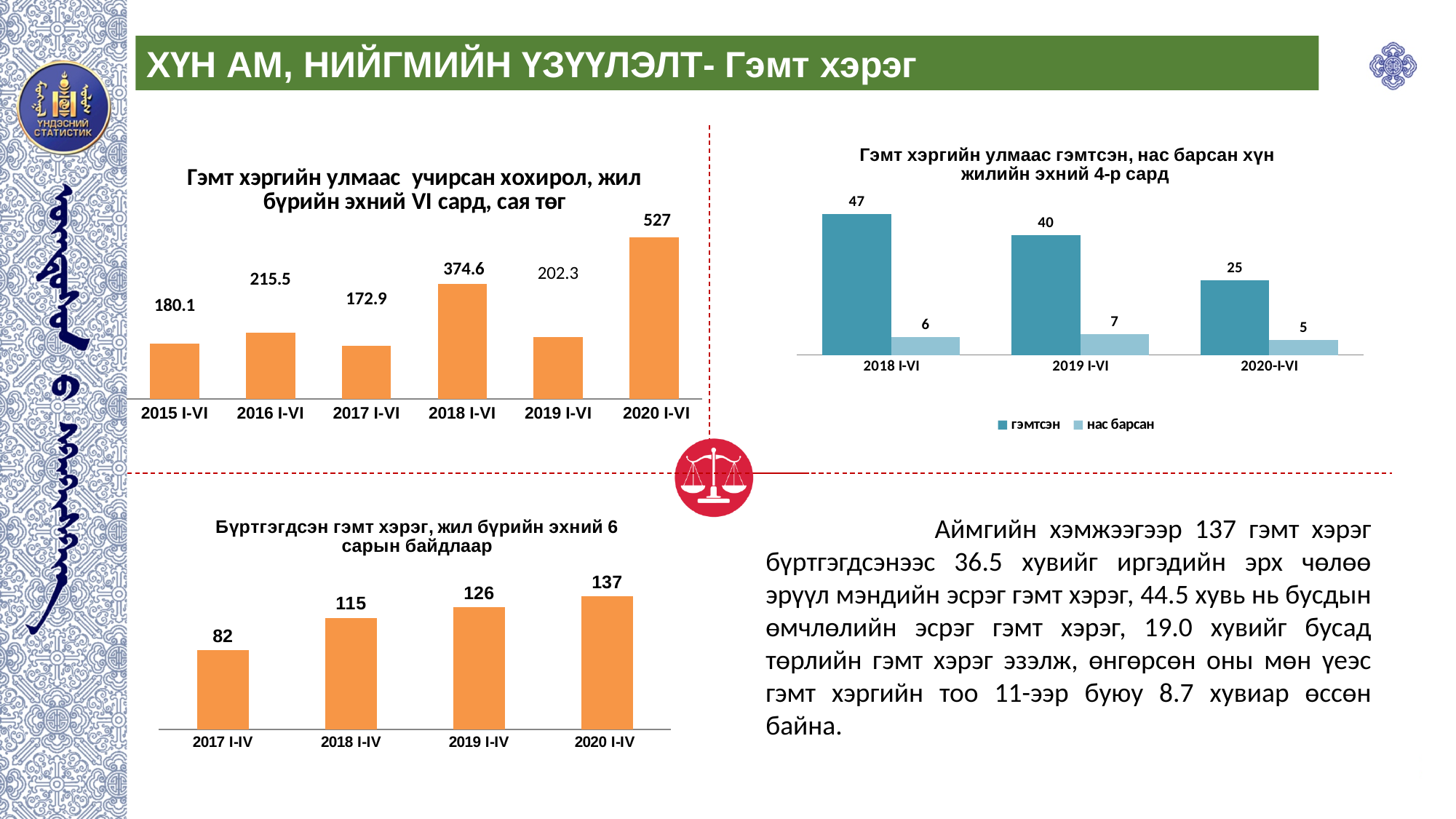
In the top-right chart (Гэмт хэргийн улмаас гэмтсэн, нас барсан хүн), what is the value of нас барсан for 2020-I-VI? 5 In the top-right chart (Гэмт хэргийн улмаас гэмтсэн, нас барсан хүн), does the гэмтсэн series rise or fall from 2018 I-VI to 2020-I-VI? fall In the top-right chart (Гэмт хэргийн улмаас гэмтсэн, нас барсан хүн), what is the value of гэмтсэн for 2019 I-VI? 40 In the top-left chart (Гэмт хэргийн улмаас учирсан хохирол), which category has the lowest value? 2017 I-VI In the top-left chart (Гэмт хэргийн улмаас учирсан хохирол), which category has the highest value? 2020 I-VI In the top-left chart (Гэмт хэргийн улмаас учирсан хохирол), what is the value for 2018 I-VI? 374.6 In the top-left chart (Гэмт хэргийн улмаас учирсан хохирол), how many categories are shown on the x axis? 6 What kind of chart is the bottom-left chart (Бүртгэгдсэн гэмт хэрэг)? bar chart In the bottom-left chart (Бүртгэгдсэн гэмт хэрэг), what is the value for 2017 I-IV? 82 In the bottom-left chart (Бүртгэгдсэн гэмт хэрэг), what is the difference between the values for 2020 I-IV and 2019 I-IV? 11 In the top-left chart (Гэмт хэргийн улмаас учирсан хохирол), what is the difference between the values for 2020 I-VI and 2019 I-VI? 324.7 In the top-right chart (Гэмт хэргийн улмаас гэмтсэн, нас барсан хүн), how many series does the legend list? 2